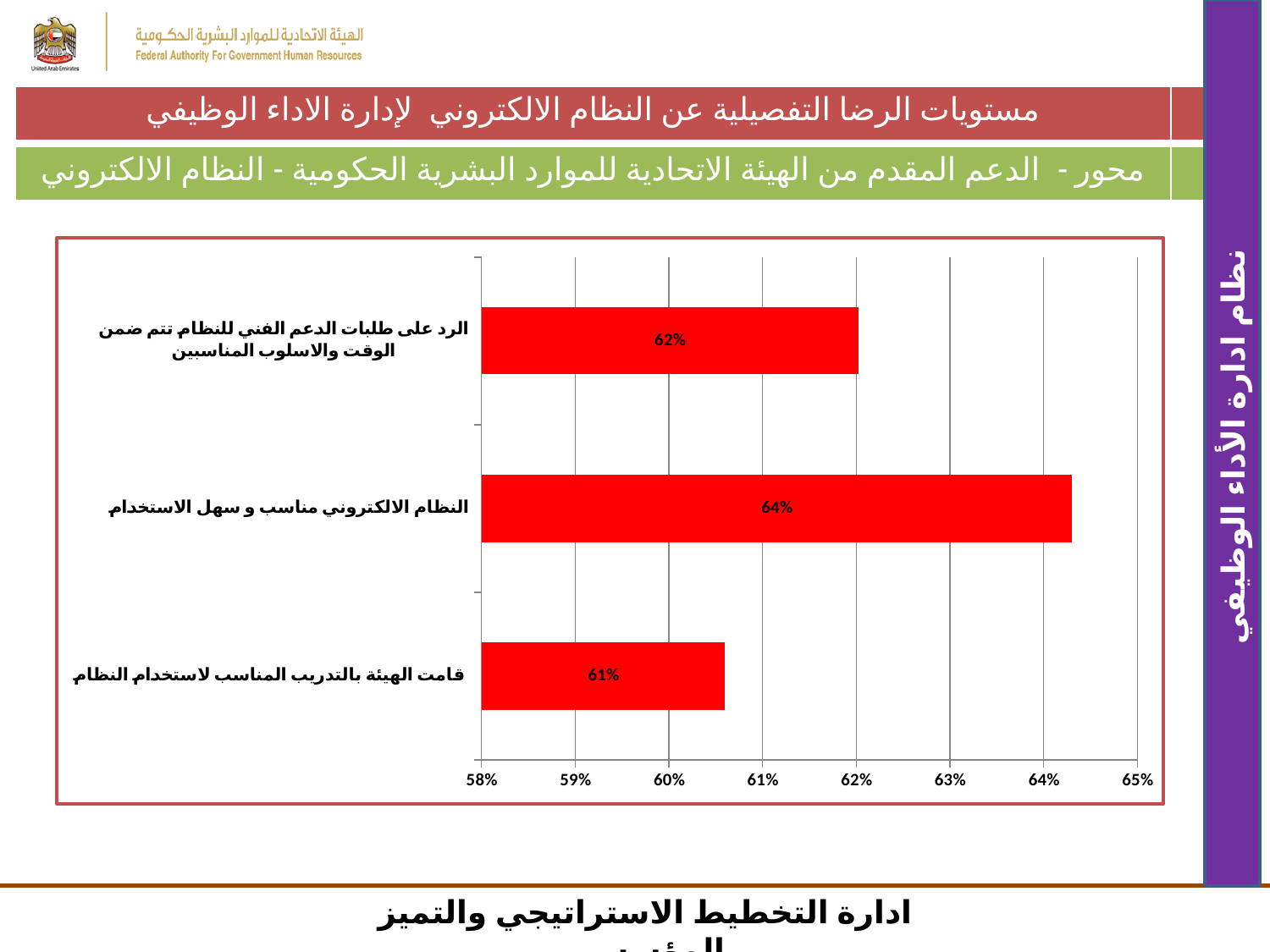
Is the value for "قامت الهيئة بالتدريب المناسب لاستخدام النظام" greater or less than 62%? less What is the value for "الرد على طلبات الدعم الفني للنظام تتم ضمن الوقت والاسلوب المناسبين"? 62% How many categories are shown in the chart? 3 What is the difference between the values for "النظام الالكتروني مناسب و سهل الاستخدام" and "قامت الهيئة بالتدريب المناسب لاستخدام النظام"? 3% What kind of chart is shown on the slide? Bar chart What is the value for "النظام الالكتروني مناسب و سهل الاستخدام"? 64% What colour are the bars in the chart? Red Which is larger: the value for "الرد على طلبات الدعم الفني للنظام تتم ضمن الوقت والاسلوب المناسبين" or the value for "قامت الهيئة بالتدريب المناسب لاستخدام النظام"? الرد على طلبات الدعم الفني للنظام تتم ضمن الوقت والاسلوب المناسبين Which category has the highest value? النظام الالكتروني مناسب و سهل الاستخدام What is the value for "قامت الهيئة بالتدريب المناسب لاستخدام النظام"? 61% Which category has the lowest value? قامت الهيئة بالتدريب المناسب لاستخدام النظام Is the value for "النظام الالكتروني مناسب و سهل الاستخدام" greater or less than 63%? greater